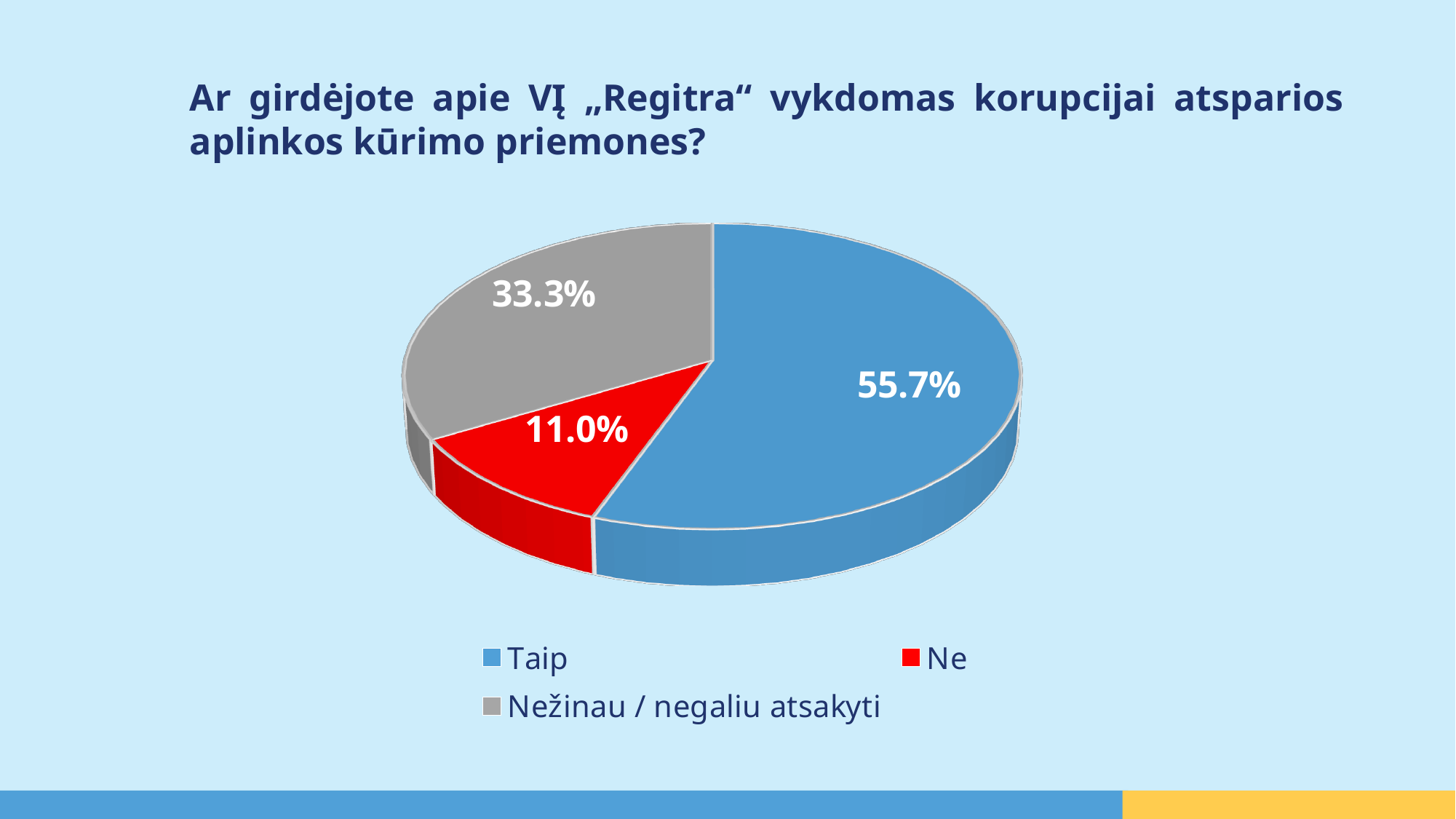
What is the difference in percentage points between "Nežinau / negaliu atsakyti" and "Ne"? 22.3 What colour is the slice for "Ne"? Red Which answer has the largest share of the pie? Taip Which answer has the smallest share of the pie? Ne How many slices does the pie chart have? 3 What percentage of respondents answered "Taip"? 55.7% What is the difference in percentage points between "Taip" and "Ne"? 44.7 What kind of chart is shown on the slide? Pie chart What percentage of respondents answered "Nežinau / negaliu atsakyti"? 33.3% Which is larger, the share for "Ne" or the share for "Nežinau / negaliu atsakyti"? Nežinau / negaliu atsakyti Which legend entry is shown in grey? Nežinau / negaliu atsakyti What percentage of respondents answered "Ne"? 11.0%